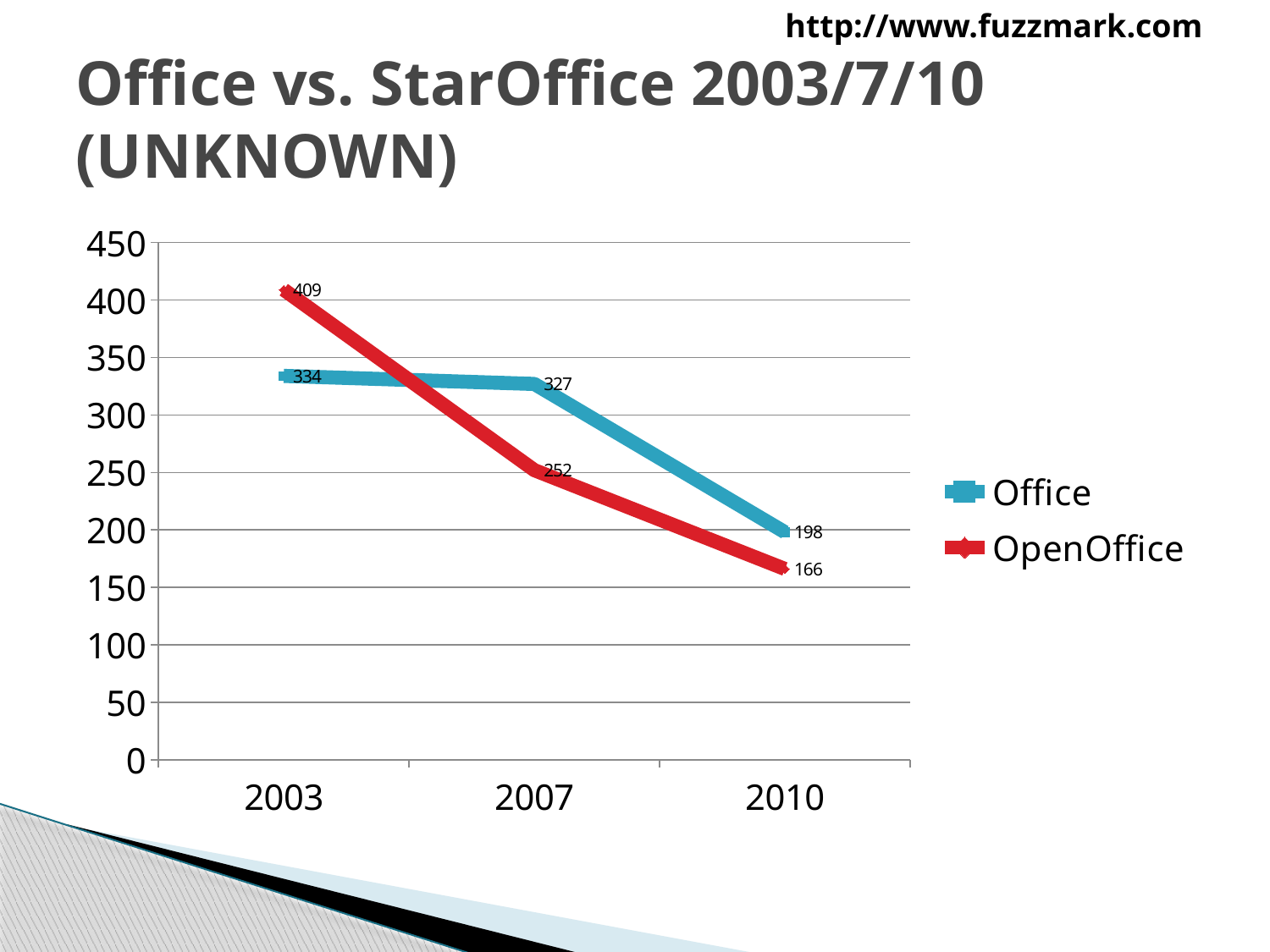
How many series does the legend list? 2 Which series has the larger value in 2007, Office or OpenOffice? Office What is the difference between the OpenOffice and Office values in 2003? 75 What is the value for OpenOffice in 2007? 252 In which year is the Office value lowest? 2010 What is the value for Office in 2010? 198 How many years are shown on the x axis? 3 What kind of chart is shown on the slide? Line chart What is the value for Office in 2003? 334 In which year is the OpenOffice value highest? 2003 Do the OpenOffice values rise or fall from 2003 to 2010? Fall What is the value for OpenOffice in 2010? 166